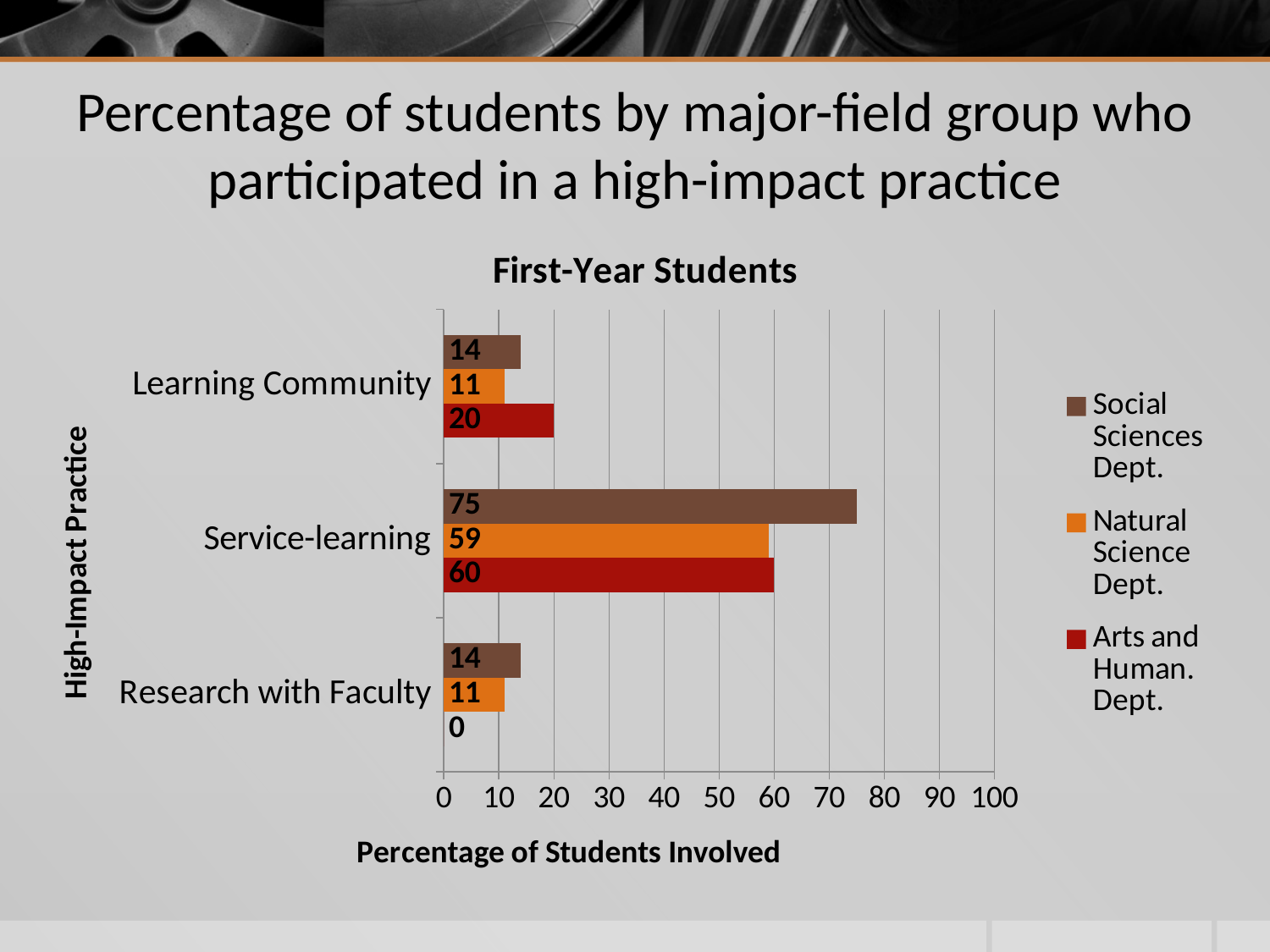
How many series does the legend list? 3 What is the difference between the Social Sciences Dept. and Natural Science Dept. values for Service-learning? 16 Which is larger for Learning Community: the Arts and Human. Dept. value or the Social Sciences Dept. value? Arts and Human. Dept. What kind of chart is shown on the slide? Bar chart What is the value for Social Sciences Dept. in the Service-learning category? 75 Which department has the highest value for Service-learning? Social Sciences Dept. What is the label of the horizontal axis? Percentage of Students Involved How many high-impact practice categories are shown on the chart? 3 What is the value for Natural Science Dept. in the Research with Faculty category? 11 Which department has the lowest value for Research with Faculty? Arts and Human. Dept. What is the title of the chart? First-Year Students What is the value for Arts and Human. Dept. in the Learning Community category? 20